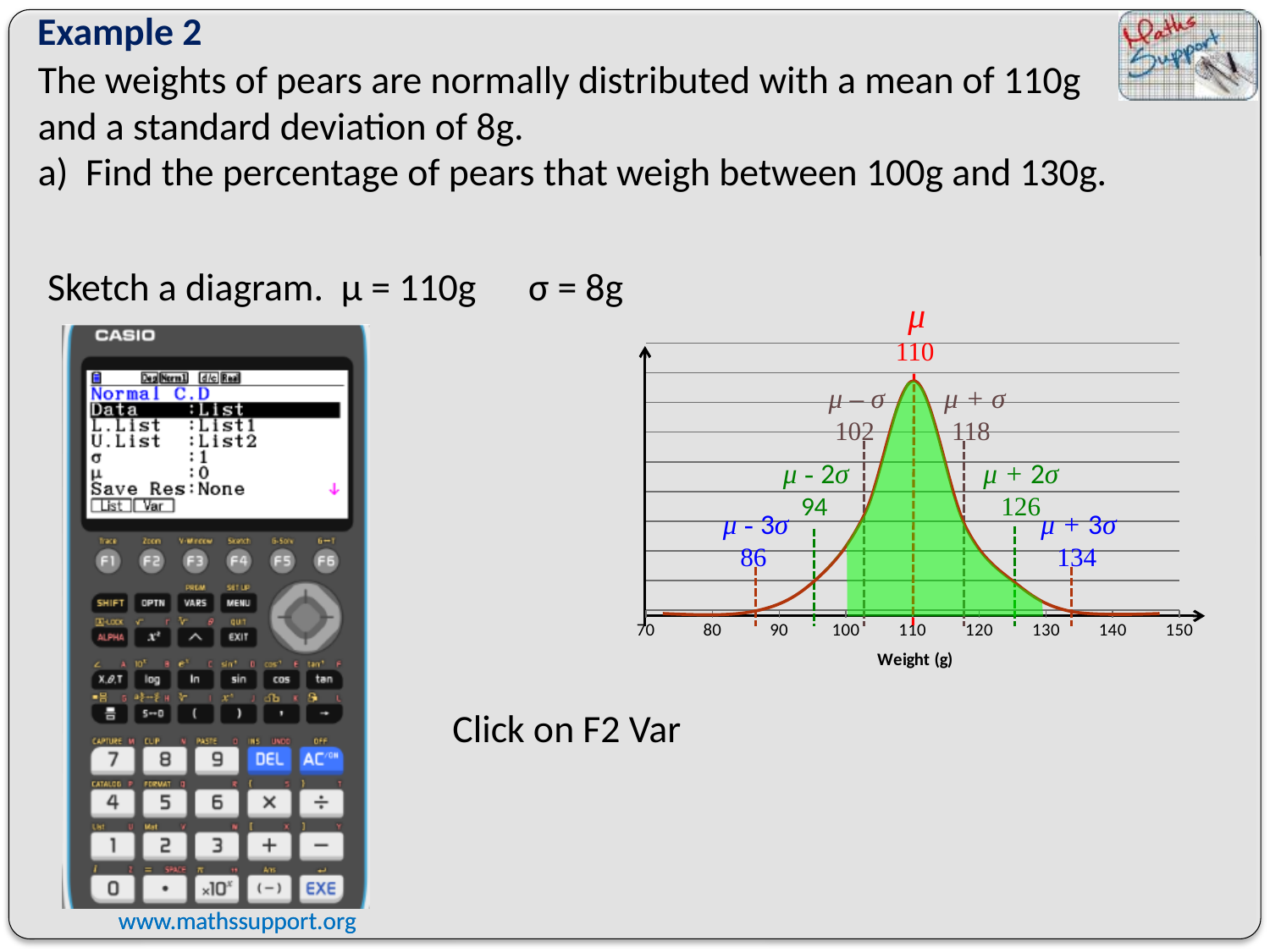
What is the difference between the values labelled at μ + σ and μ − σ? 16 Does the curve rise or fall along the x-axis from 110 to 150? fall What value is labelled at μ − σ on the chart? 102 What value is labelled at μ − 3σ on the chart? 86 What is the x-axis title of the chart? Weight (g) Which is larger, the value labelled at μ − σ or the value labelled at μ − 2σ? μ − σ (102) What value is labelled at μ on the chart? 110 What value is labelled at μ + 2σ on the chart? 126 What value is labelled at μ + 3σ on the chart? 134 How many tick labels are shown on the x-axis of the chart? 9 What is the difference between the values labelled at μ + 3σ and μ − 3σ? 48 What value is labelled at μ + σ on the chart? 118